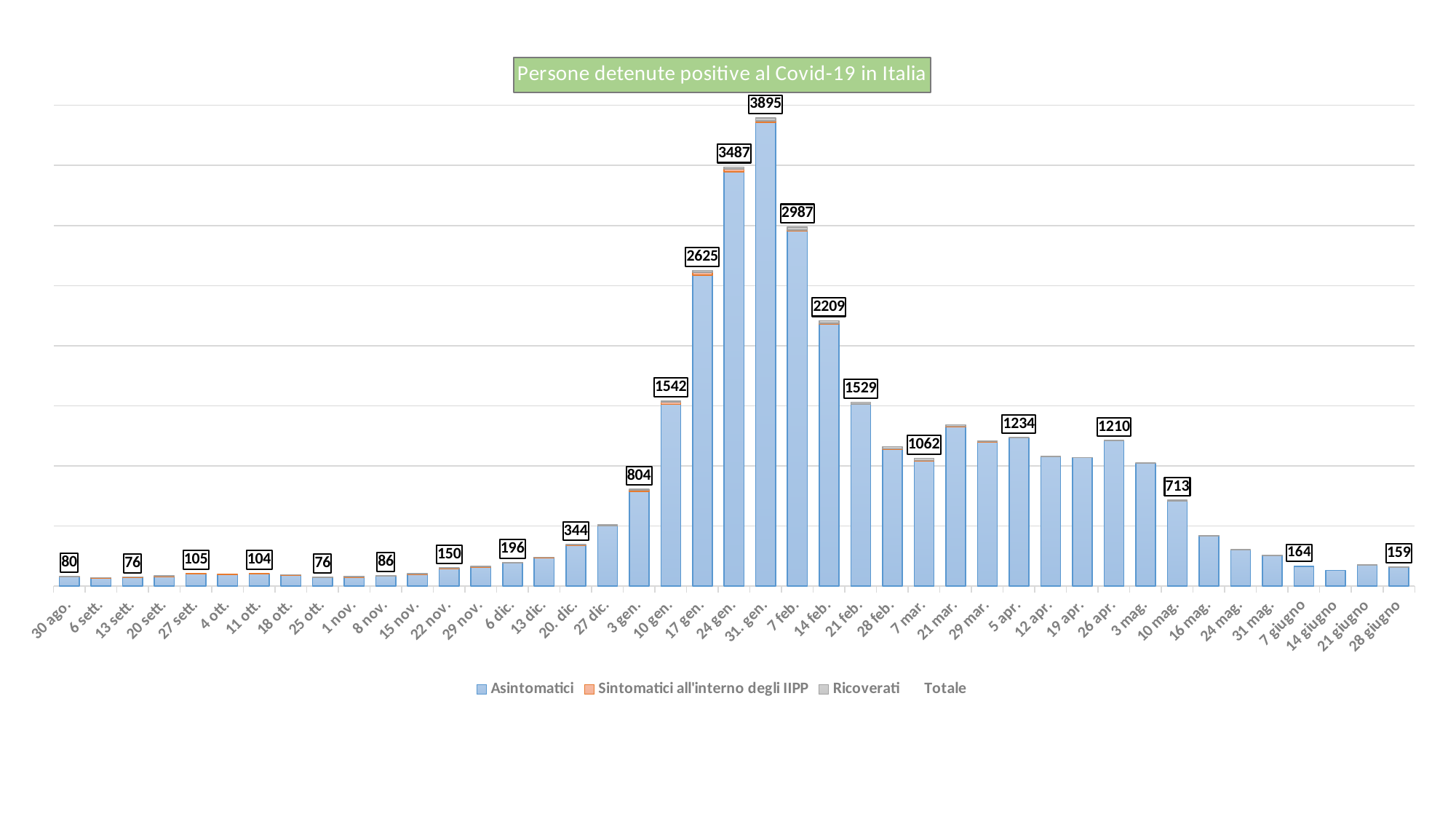
How many dates are shown on the x axis? 43 What is the total value shown for 7 feb.? 2987 Which is larger, the total for 14 feb. or the total for 21 feb.? 14 feb. What is the title of the chart? Persone detenute positive al Covid-19 in Italia What is the total value shown for 10 gen.? 1542 What is the total value shown for 31. gen.? 3895 What is the total value shown for 28 giugno? 159 How many series does the legend list? 4 What kind of chart is this? Stacked bar chart Which date has the highest total? 31. gen. What is the difference between the totals for 24 gen. and 17 gen.? 862 What is the difference between the totals for 5 apr. and 26 apr.? 24